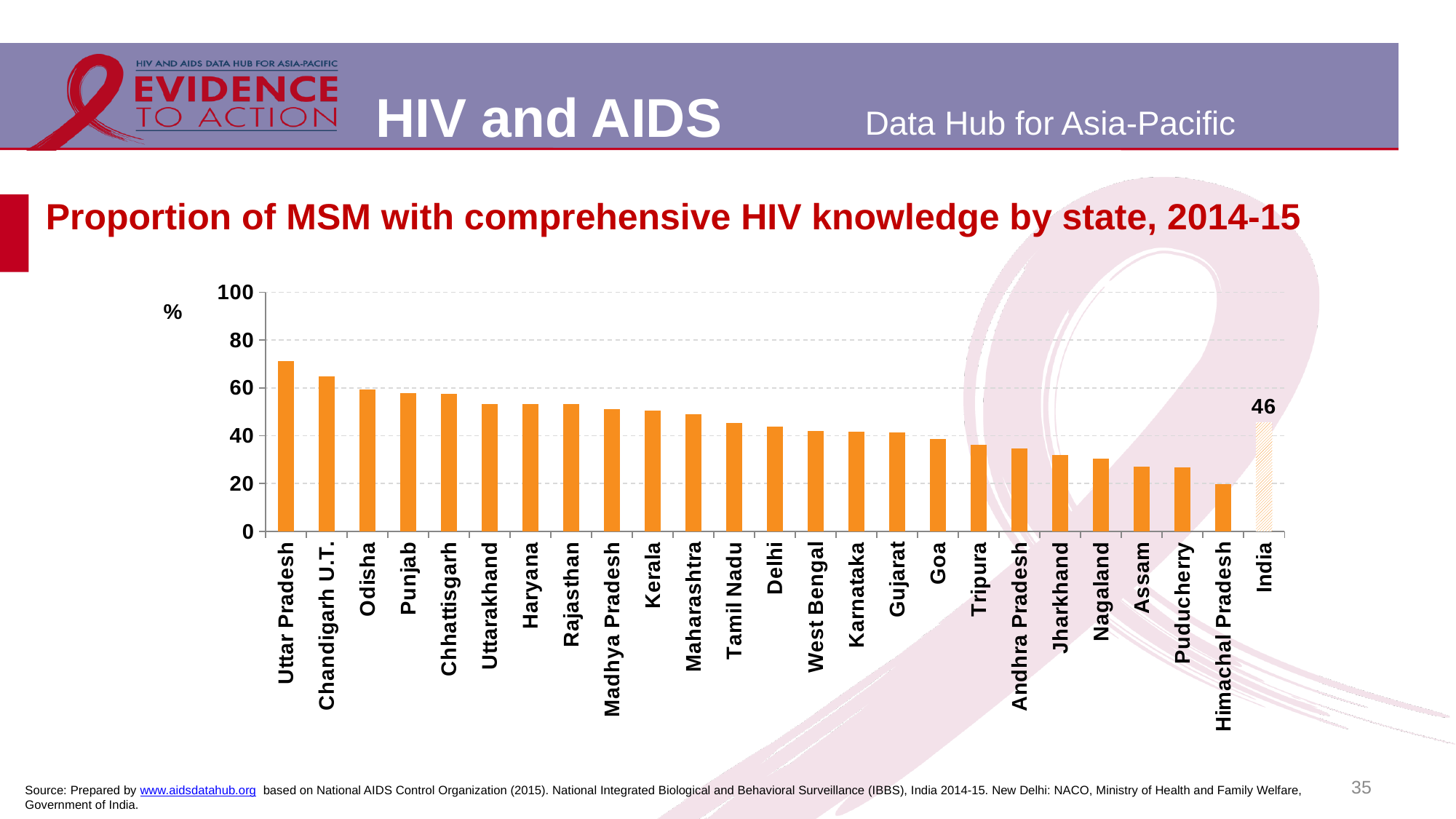
Which is larger, the value for Delhi or the value for Tripura? Delhi Is the value for Goa greater or less than 40? less What is the value shown for India? 46 Is the value for Uttar Pradesh greater or less than 60? greater How many bars are plotted in the chart, including India? 25 Do the state values rise or fall moving from left to right along the x axis? Fall Which is larger, the value for Chandigarh U.T. or the value for Nagaland? Chandigarh U.T. Is the value for Assam greater or less than 40? less Which state has the lowest proportion of MSM with comprehensive HIV knowledge? Himachal Pradesh Which state has the highest proportion of MSM with comprehensive HIV knowledge? Uttar Pradesh What kind of chart is shown on the slide? Bar chart